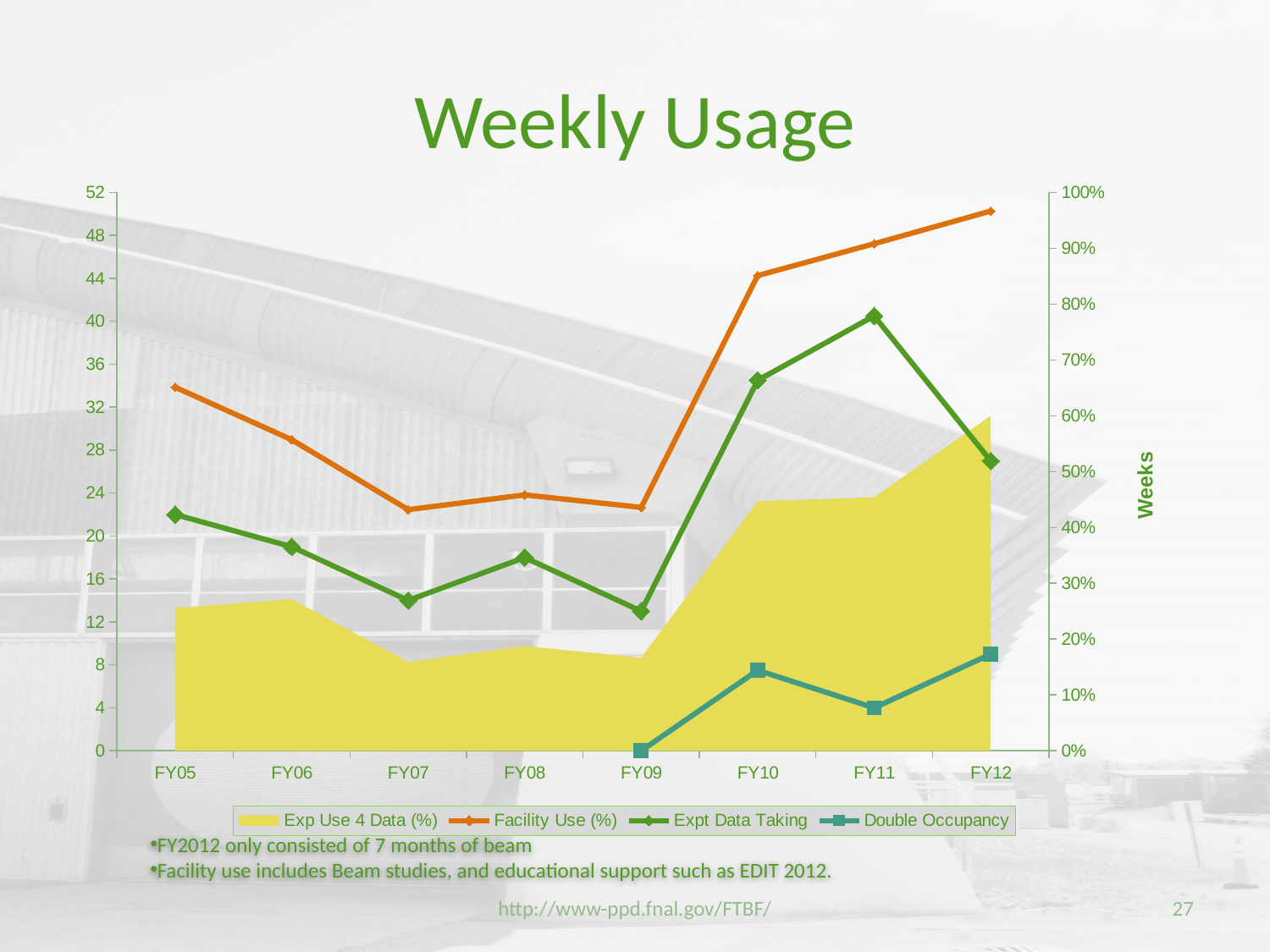
Is the value for Facility Use (%) in FY10 greater or less than 80%? greater In which fiscal year is Expt Data Taking highest? FY11 How many fiscal years are shown on the x axis? 8 Which series is drawn as a shaded area rather than a line? Exp Use 4 Data (%) In which fiscal year is Double Occupancy lowest? FY09 In which fiscal year is Double Occupancy highest? FY12 In which fiscal year is Facility Use (%) highest? FY12 How many series does the legend list? 4 What is the title of the chart? Weekly Usage